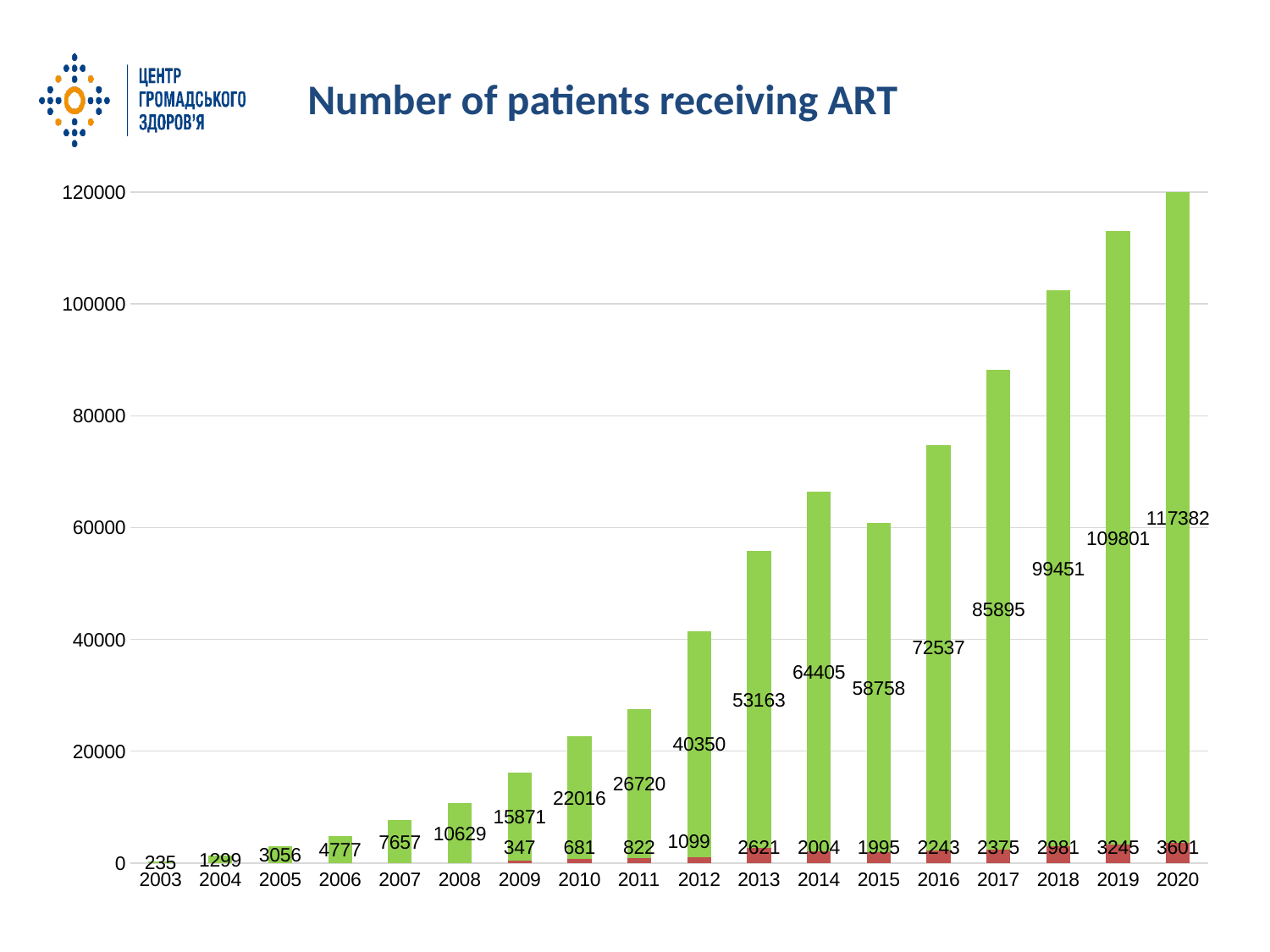
What kind of chart is shown on the slide? bar chart Which year has the larger green bar value, 2014 or 2015? 2014 What is the value of the red bar segment for 2013? 2621 What is the value of the green bar segment for 2015? 58758 Is the total height of the stacked bar for 2016 greater or less than 80000? less Which year has the lowest green bar value? 2003 What is the total of the stacked bar for 2020 (green plus red segments)? 120983 How many years are shown on the x axis? 18 What is the difference between the green bar values for 2020 and 2019? 7581 Which year has the highest green bar value? 2020 What is the value of the red bar segment for 2009? 347 Do the green bar values rise or fall from 2003 to 2014? rise